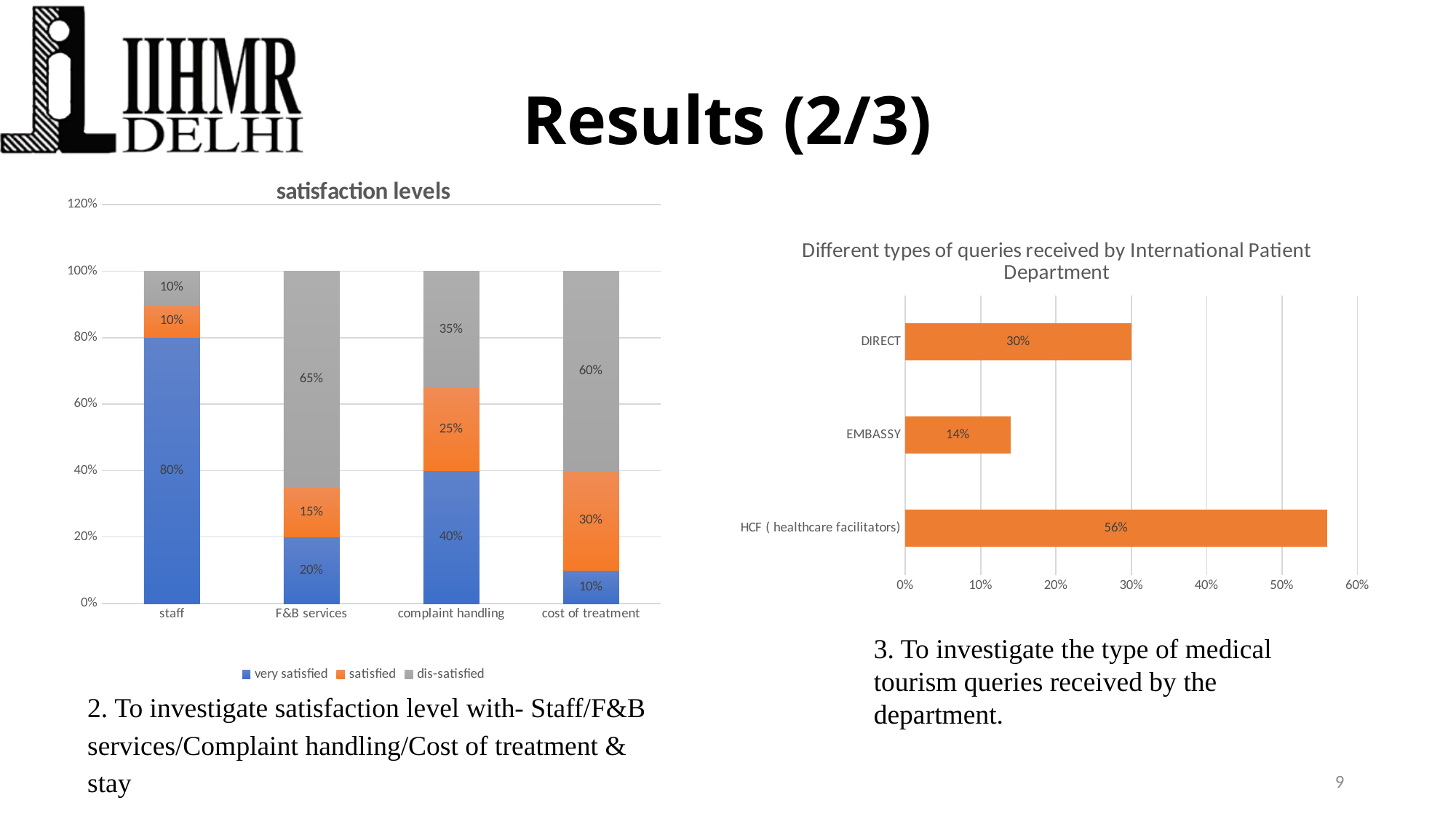
In the 'satisfaction levels' chart, which category has the lowest 'very satisfied' value? cost of treatment In the 'satisfaction levels' chart, what is the 'satisfied' value for complaint handling? 25% In the 'satisfaction levels' chart, what is the difference between the 'dis-satisfied' values for cost of treatment and complaint handling? 25% In the 'satisfaction levels' chart, what is the 'very satisfied' value for staff? 80% In the 'satisfaction levels' chart, what is the 'dis-satisfied' value for F&B services? 65% In the 'Different types of queries received by International Patient Department' chart, what is the value for EMBASSY? 14% In the 'Different types of queries received by International Patient Department' chart, which category has the highest value? HCF ( healthcare facilitators) In the 'Different types of queries received by International Patient Department' chart, what is the difference between the values for HCF ( healthcare facilitators) and DIRECT? 26% What kind of chart is the 'Different types of queries received by International Patient Department' chart? bar chart In the 'satisfaction levels' chart, which category has the highest 'very satisfied' value? staff In the 'satisfaction levels' chart, how many series does the legend list? 3 In the 'satisfaction levels' chart, how many categories are shown on the x axis? 4